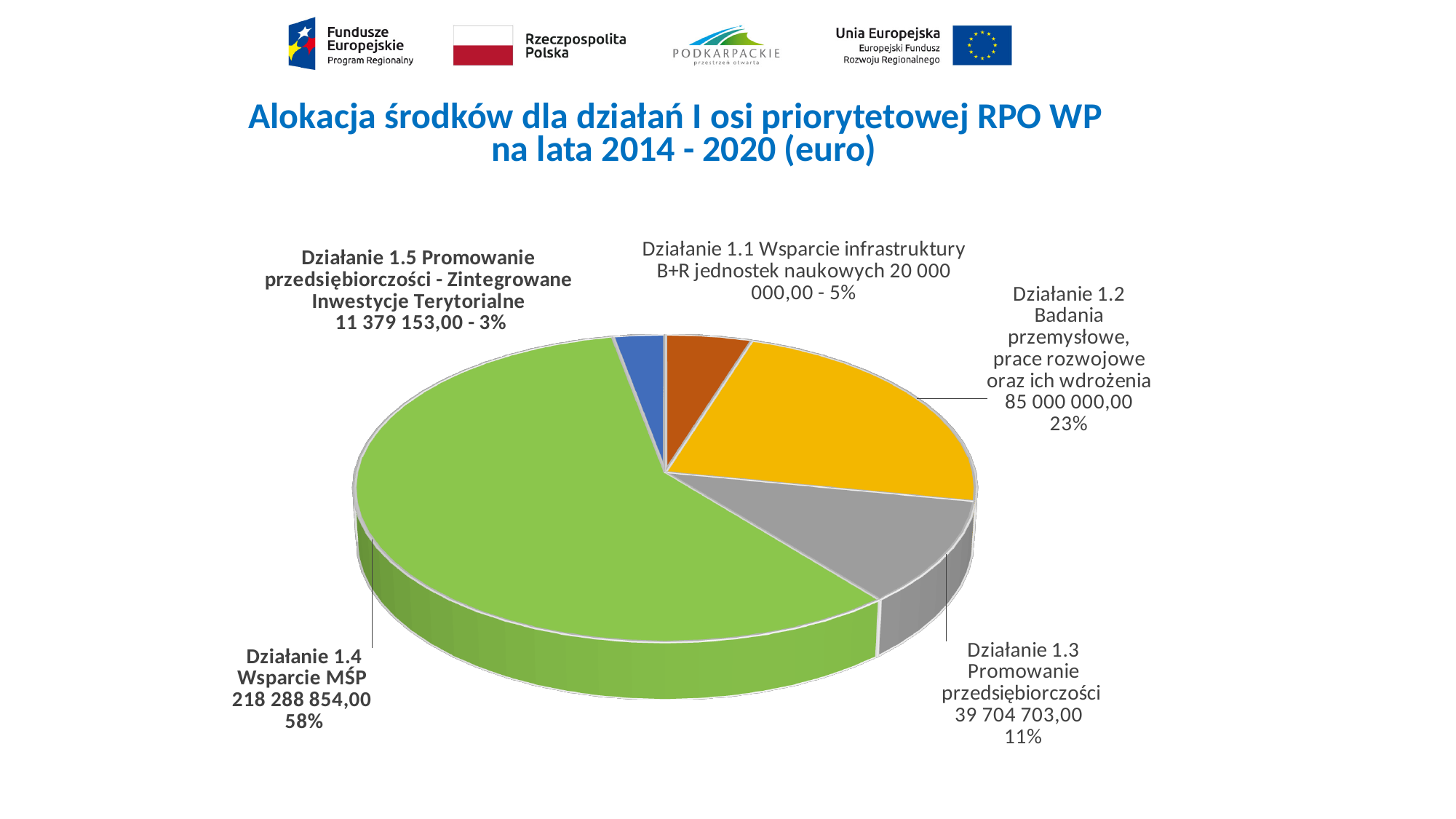
Which has a larger allocation, Działanie 1.2 or Działanie 1.3? Działanie 1.2 Which działanie has the largest allocation? Działanie 1.4 Wsparcie MŚP What is the allocation for Działanie 1.3 Promowanie przedsiębiorczości? 39 704 703,00 What is the allocation for Działanie 1.4 Wsparcie MŚP? 218 288 854,00 What share of the pie does Działanie 1.4 Wsparcie MŚP represent? 58% What type of chart is shown on the slide? pie chart What is the title of the chart? Alokacja środków dla działań I osi priorytetowej RPO WP na lata 2014 - 2020 (euro) What is the allocation for Działanie 1.5 Promowanie przedsiębiorczości - Zintegrowane Inwestycje Terytorialne? 11 379 153,00 How many slices does the pie chart have? 5 What share of the pie does Działanie 1.1 Wsparcie infrastruktury B+R jednostek naukowych represent? 5% What is the allocation for Działanie 1.2 Badania przemysłowe, prace rozwojowe oraz ich wdrożenia? 85 000 000,00 Which działanie has the smallest allocation? Działanie 1.5 Promowanie przedsiębiorczości - Zintegrowane Inwestycje Terytorialne